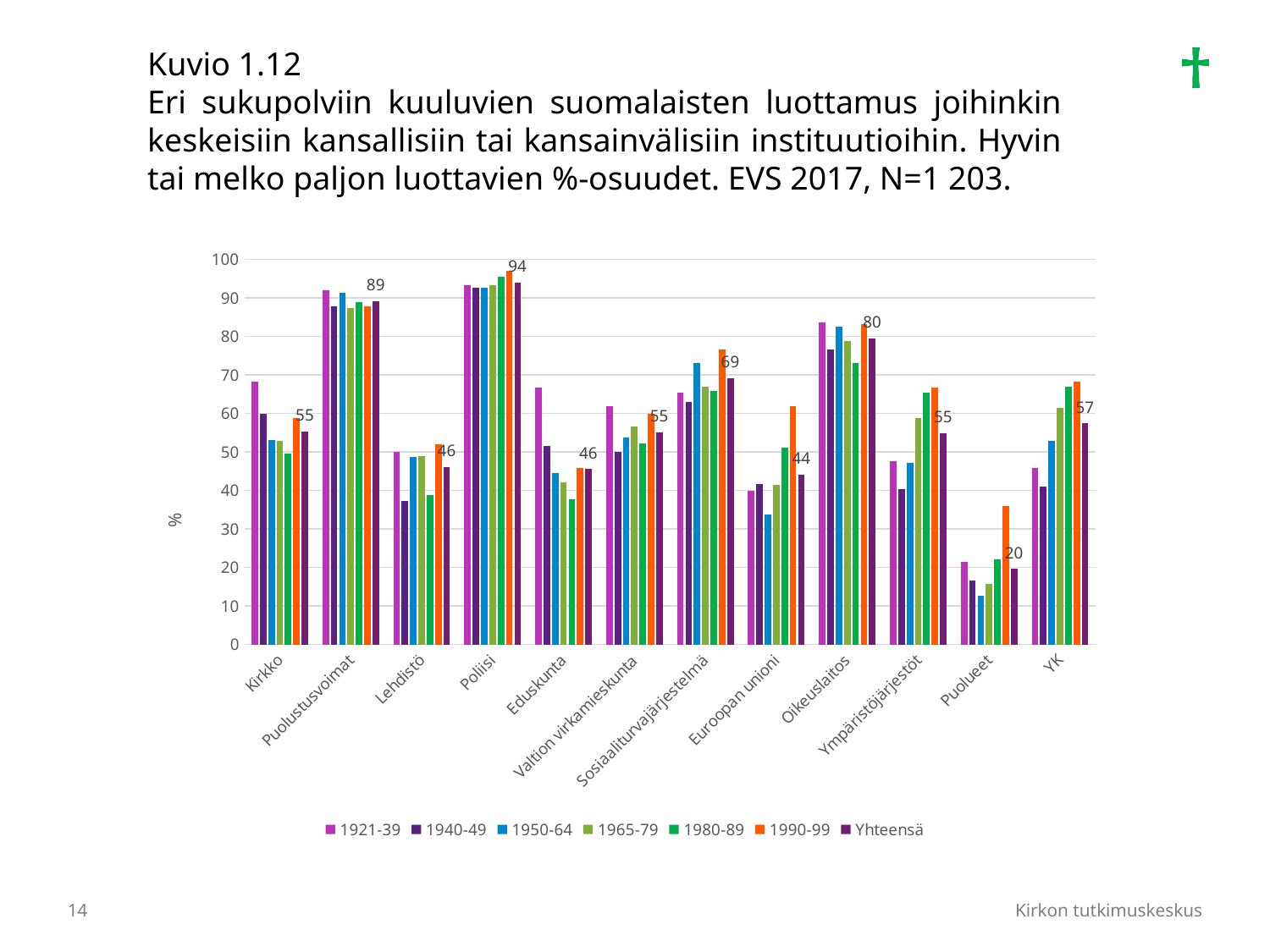
Which category has the lowest Yhteensä value? Puolueet What is the Yhteensä value for Puolueet? 20 What is the difference between the Yhteensä values for Oikeuslaitos and Sosiaaliturvajärjestelmä? 11 How many series does the legend list? 7 How many institution categories are shown on the x axis? 12 Is the value for the 1990-99 series for Puolueet greater or less than 30? greater Which series is shown in orange in the legend? 1990-99 What is the Yhteensä value for Euroopan unioni? 44 What type of chart is shown on the slide? bar chart What is the Yhteensä value for Poliisi? 94 Is the Yhteensä value for Puolustusvoimat or for YK larger? Puolustusvoimat Which category has the highest Yhteensä value? Poliisi